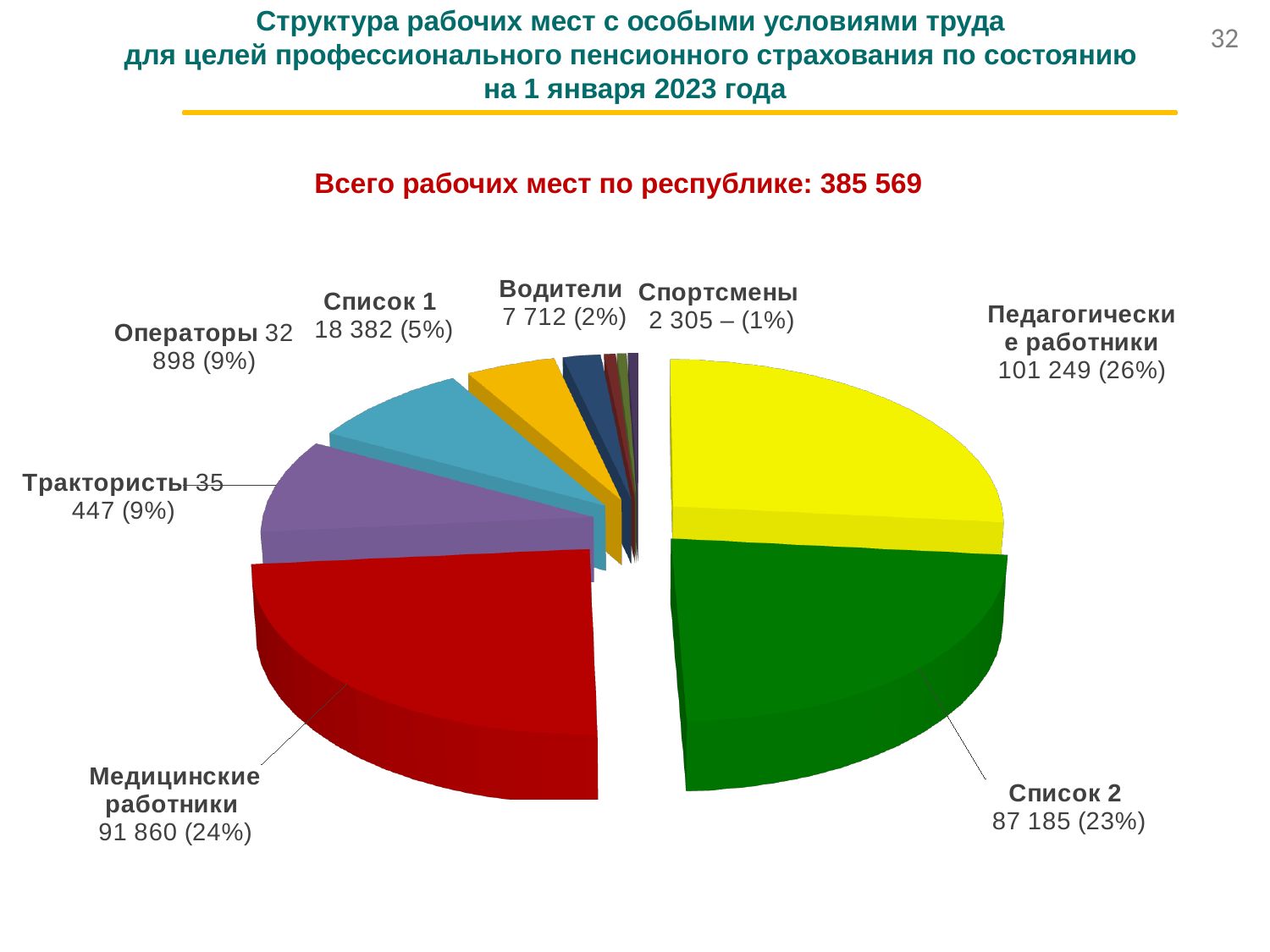
What value is shown for Водители? 7 712 (2%) How many workplaces are shown for Педагогические работники? 101 249 (26%) What kind of chart is shown on the slide? pie chart What share of the pie do Трактористы represent? 9% Which labelled category has the largest slice? Педагогические работники What is the difference between the values for Педагогические работники and Список 2? 14 064 What total number of workplaces across the republic is stated on the slide? 385 569 What value is shown for Список 2? 87 185 (23%) What value is shown for Медицинские работники? 91 860 (24%) Which labelled category has the smallest slice? Спортсмены What share of the pie does Список 1 represent? 5% Which is larger, Медицинские работники or Список 2? Медицинские работники